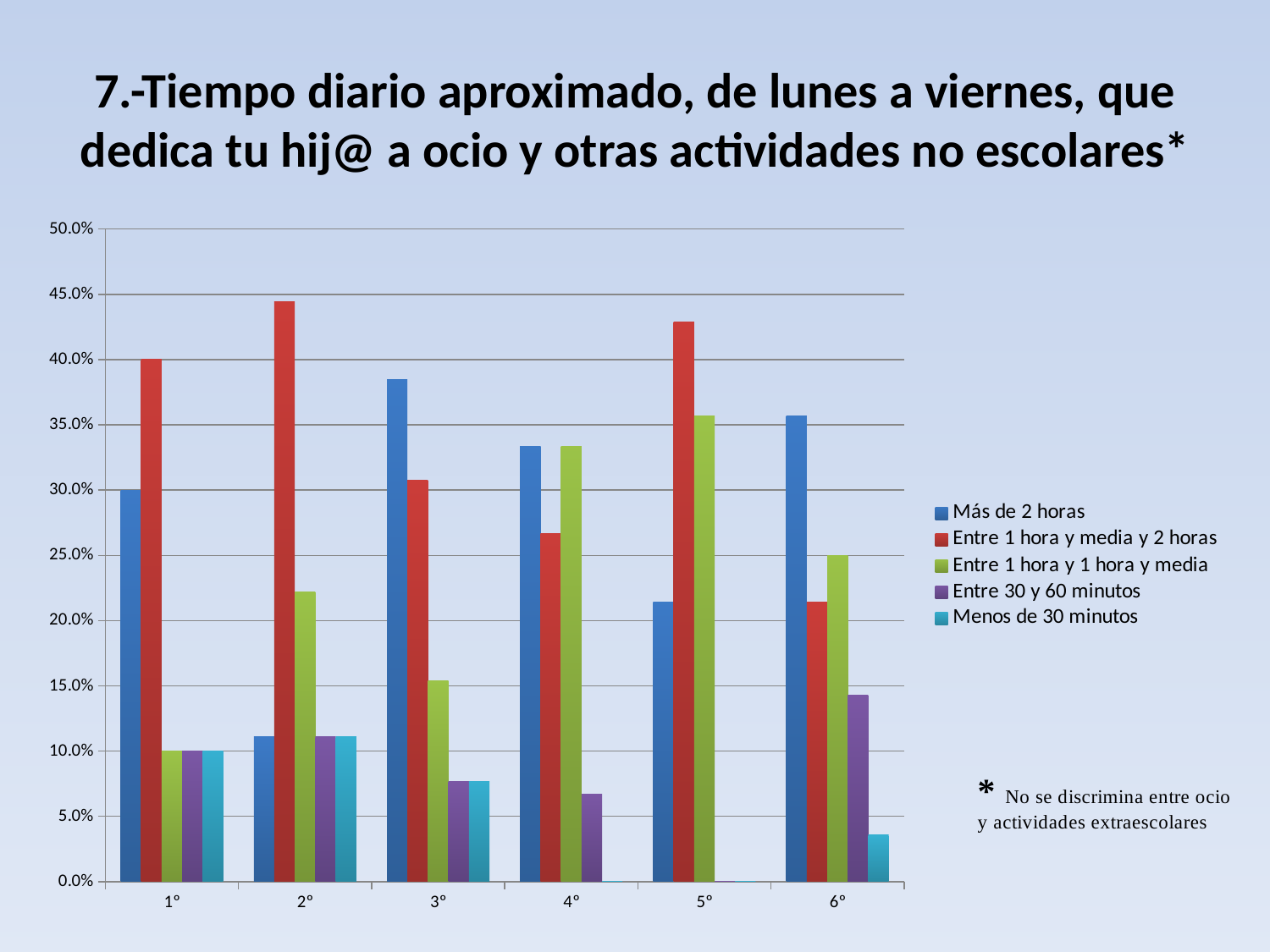
Is the value for 'Menos de 30 minutos' at 6° greater or less than 5%? less Which is larger: 'Entre 1 hora y media y 2 horas' at 2° or at 1°? 2° How many categories (grades) are shown on the x axis? 6 Which series has the highest value for 3°? Más de 2 horas Which series has the highest value for 5°? Entre 1 hora y media y 2 horas Is the value for 'Entre 1 hora y media y 2 horas' at 2° greater or less than 40%? greater How many series does the legend list? 5 What kind of chart is shown on the slide? bar chart Which series is shown in red in the legend? Entre 1 hora y media y 2 horas Is the value for 'Más de 2 horas' at 5° greater or less than 25%? less Which series has the highest value for 2°? Entre 1 hora y media y 2 horas